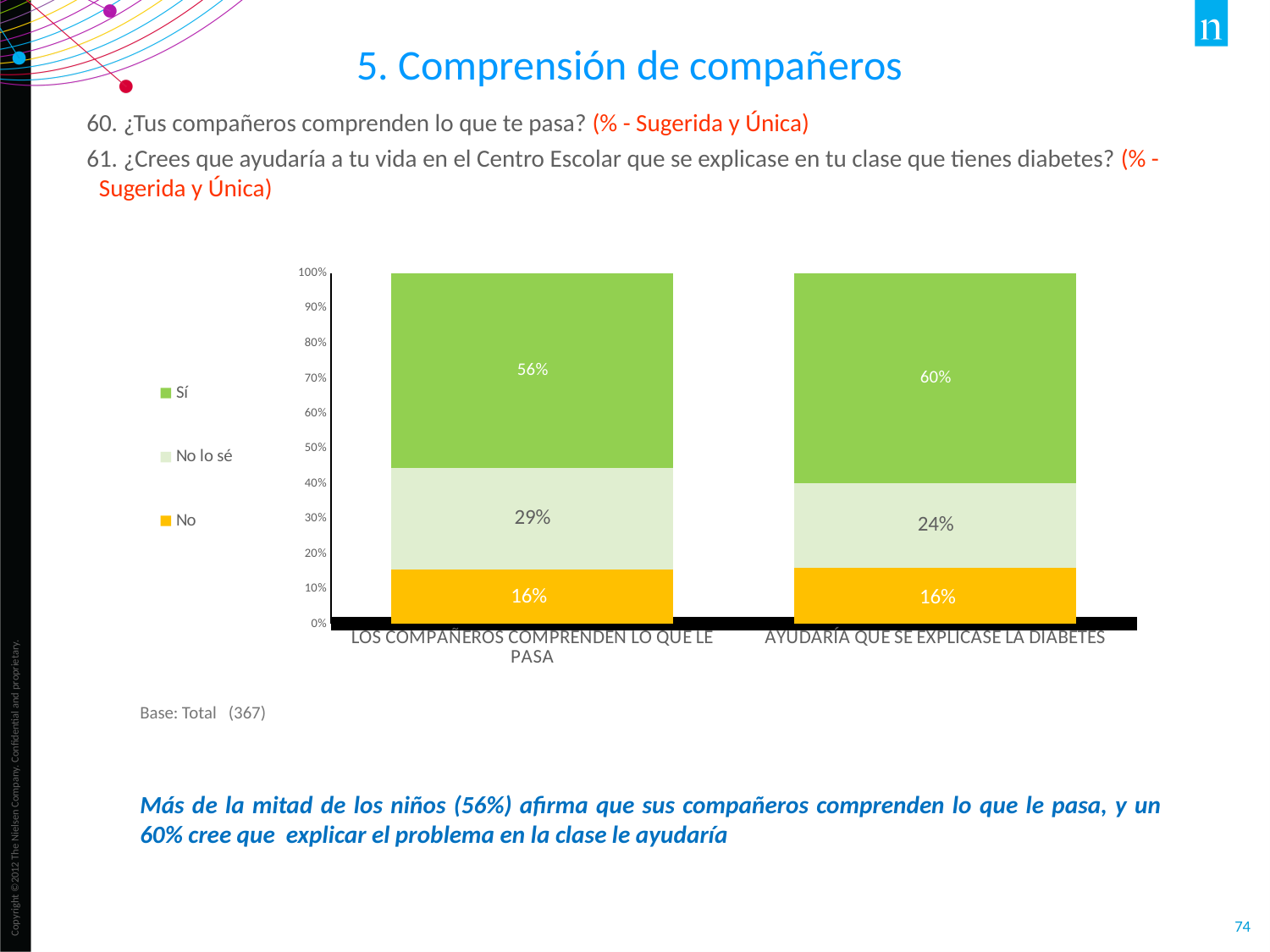
What percentage answered "No" for "LOS COMPAÑEROS COMPRENDEN LO QUE LE PASA"? 16% What percentage answered "No lo sé" for "AYUDARÍA QUE SE EXPLICASE LA DIABETES"? 24% How many series does the legend list? 3 What kind of chart is shown on the slide? Stacked bar chart What percentage answered "Sí" for "LOS COMPAÑEROS COMPRENDEN LO QUE LE PASA"? 56% Which category has the lower "No lo sé" percentage? AYUDARÍA QUE SE EXPLICASE LA DIABETES What is the base (total) stated below the chart? 367 Is the "No lo sé" value larger for "LOS COMPAÑEROS COMPRENDEN LO QUE LE PASA" or for "AYUDARÍA QUE SE EXPLICASE LA DIABETES"? LOS COMPAÑEROS COMPRENDEN LO QUE LE PASA Which category has the higher "Sí" percentage? AYUDARÍA QUE SE EXPLICASE LA DIABETES How many categories are shown on the x axis of the chart? 2 What is the difference between the "Sí" percentages of the two categories? 4% What percentage answered "Sí" for "AYUDARÍA QUE SE EXPLICASE LA DIABETES"? 60%